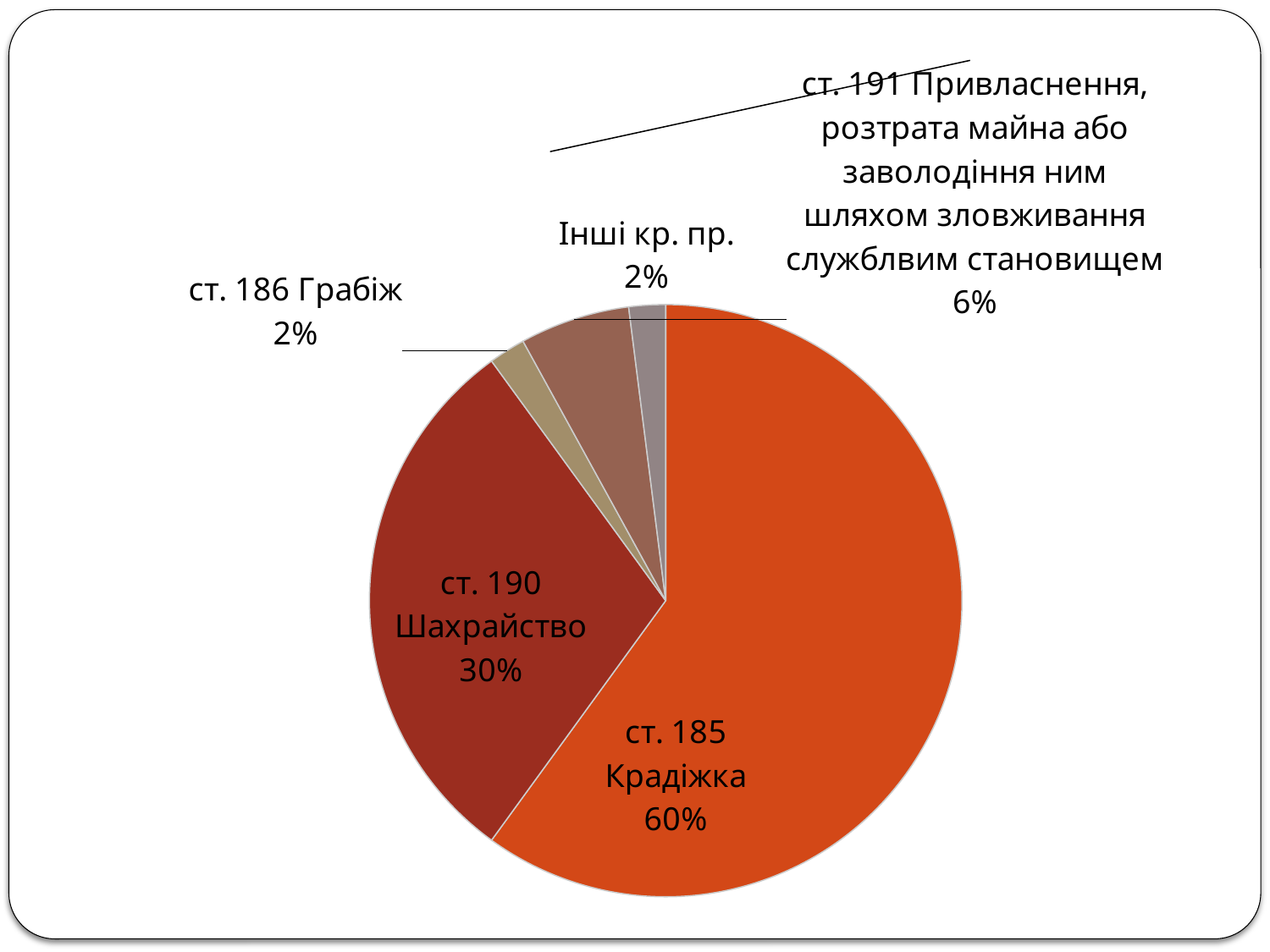
Which category has the largest slice of the pie? ст. 185 Крадіжка How many slices does the pie chart have? 5 What is the combined share of ст. 185 Крадіжка and ст. 190 Шахрайство? 90% What share of the pie does ст. 185 Крадіжка have? 60% What share of the pie does ст. 190 Шахрайство have? 30% What percentage is shown for ст. 186 Грабіж? 2% Which is larger, the share for ст. 190 Шахрайство or the share for ст. 191 Привласнення? ст. 190 Шахрайство What percentage is shown for Інші кр. пр.? 2% What kind of chart is shown on the slide? pie chart What percentage is shown for ст. 191 Привласнення, розтрата майна або заволодіння ним шляхом зловживання службовим становищем? 6% What colour is the slice for ст. 185 Крадіжка? orange What is the difference in percentage points between ст. 185 Крадіжка and ст. 190 Шахрайство? 30